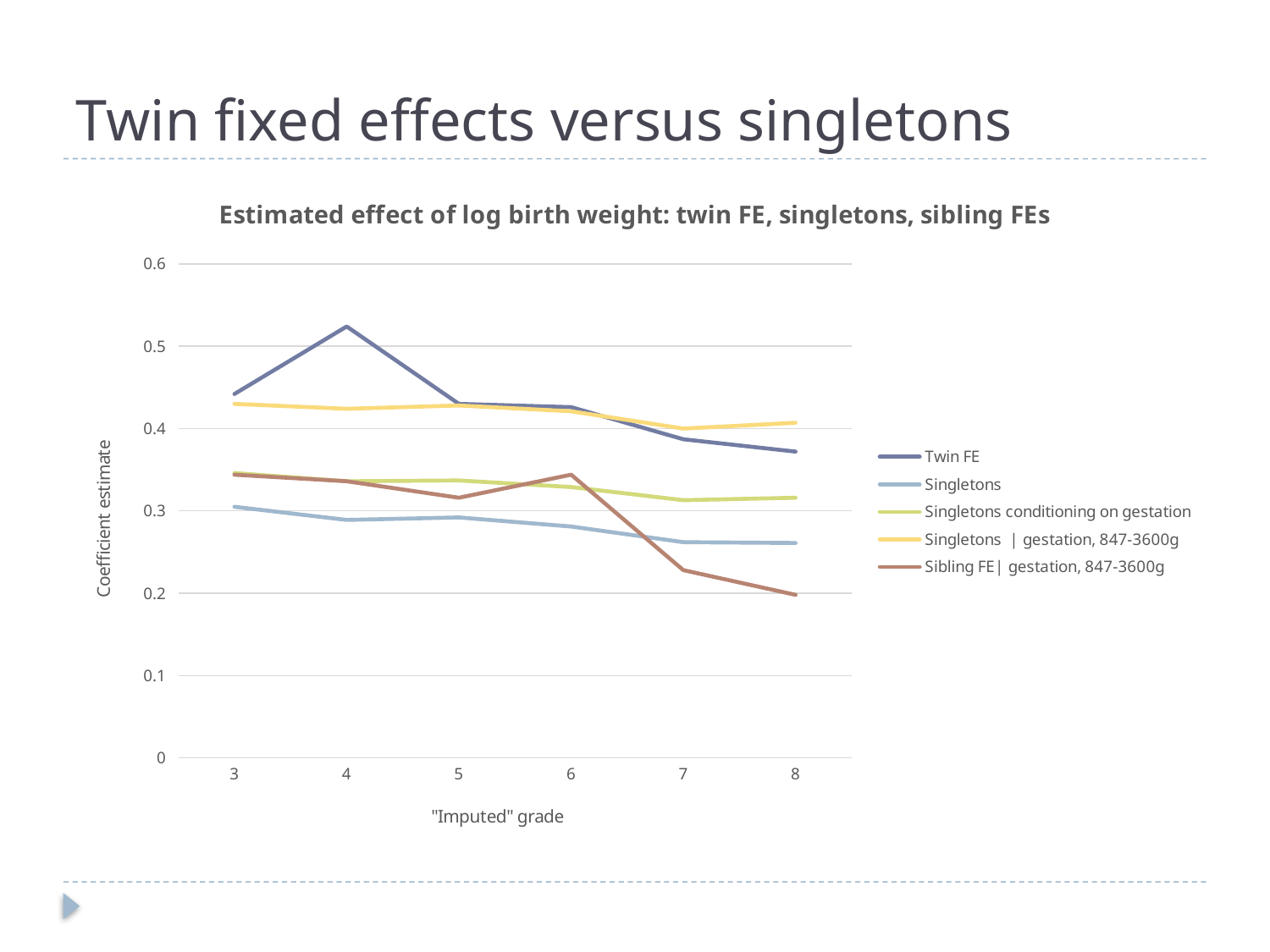
What is the label of the y axis? Coefficient estimate At which "imputed" grade does the Twin FE series reach its highest value? 4 Is the Twin FE value at grade 4 greater or less than 0.5? greater What is the title of the chart? Estimated effect of log birth weight: twin FE, singletons, sibling FEs How many series does the legend list? 5 How many "imputed" grade values are plotted along the x axis? 6 What kind of chart is shown on the slide? Line chart Which series has the lowest value at grade 8? Sibling FE| gestation, 847-3600g Does the Singletons series rise or fall from grade 3 to grade 8? Fall Is the Singletons value at grade 8 greater or less than 0.3? less At grade 8, which is larger: the Singletons value or the Sibling FE| gestation, 847-3600g value? Singletons Is the Twin FE value at grade 8 greater or less than 0.4? less